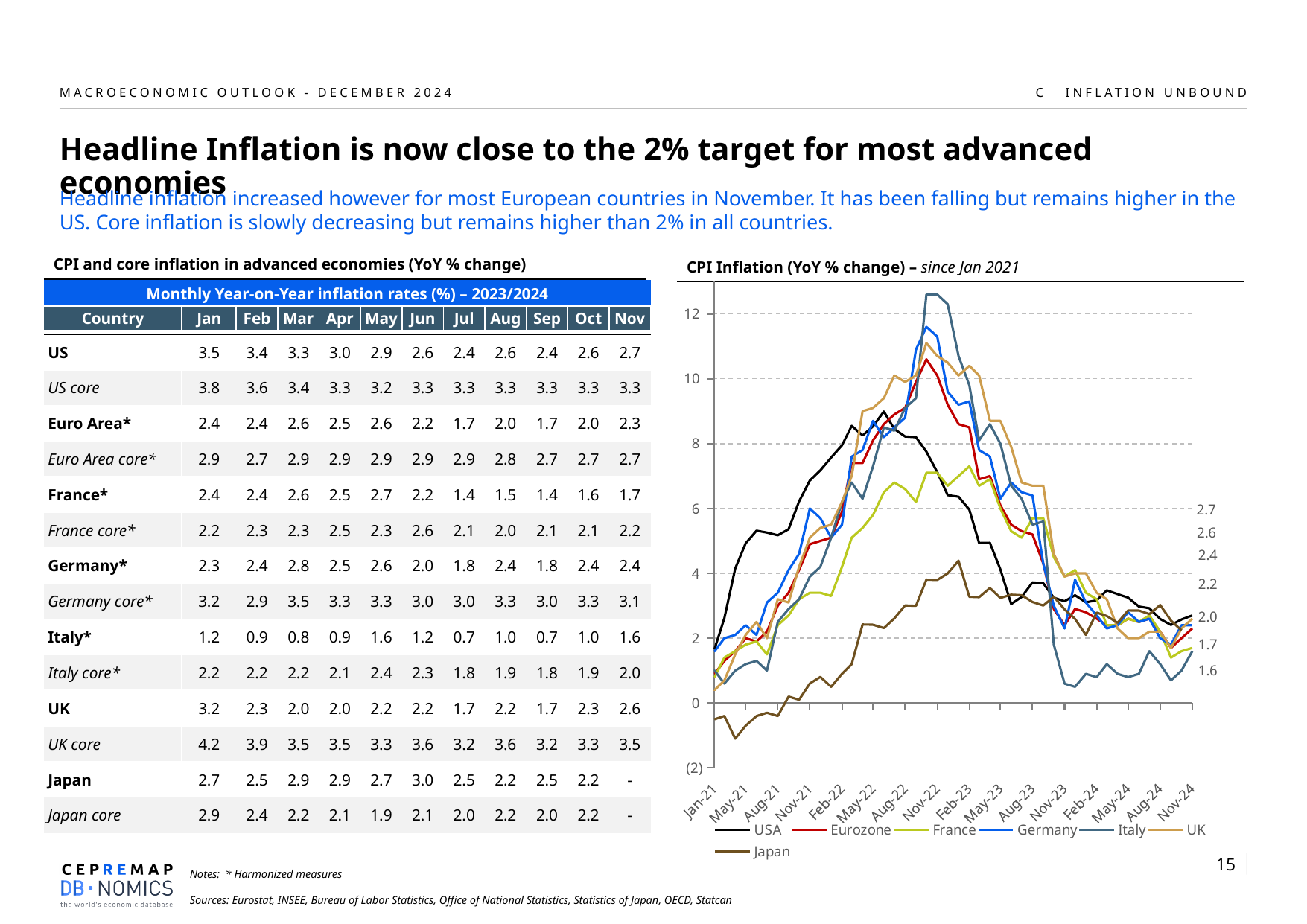
In the 'CPI Inflation (YoY % change)' chart, does the USA series rise or fall between Jan-21 and mid-2022? rise In the 'CPI Inflation (YoY % change)' chart, which series reaches the highest peak? Italy What is the title of the line chart on the right of the slide? CPI Inflation (YoY % change) – since Jan 2021 In the 'CPI Inflation (YoY % change)' chart, is the value for Japan in Jan-21 greater or less than 0? less In the 'CPI Inflation (YoY % change)' chart, is the peak value for Italy greater or less than 12? greater In the 'CPI Inflation (YoY % change)' chart, does the Italy series rise or fall between Nov-22 and Nov-23? fall In the 'CPI Inflation (YoY % change)' chart, is the peak value for the UK greater or less than 10? greater In the 'CPI Inflation (YoY % change)' chart, which series peaks higher, Italy or France? Italy How many series does the legend of the 'CPI Inflation (YoY % change)' chart list? 7 What kind of chart is the 'CPI Inflation (YoY % change)' chart on the right of the slide? line chart In the 'CPI Inflation (YoY % change)' chart, which series has the lowest values during 2021? Japan